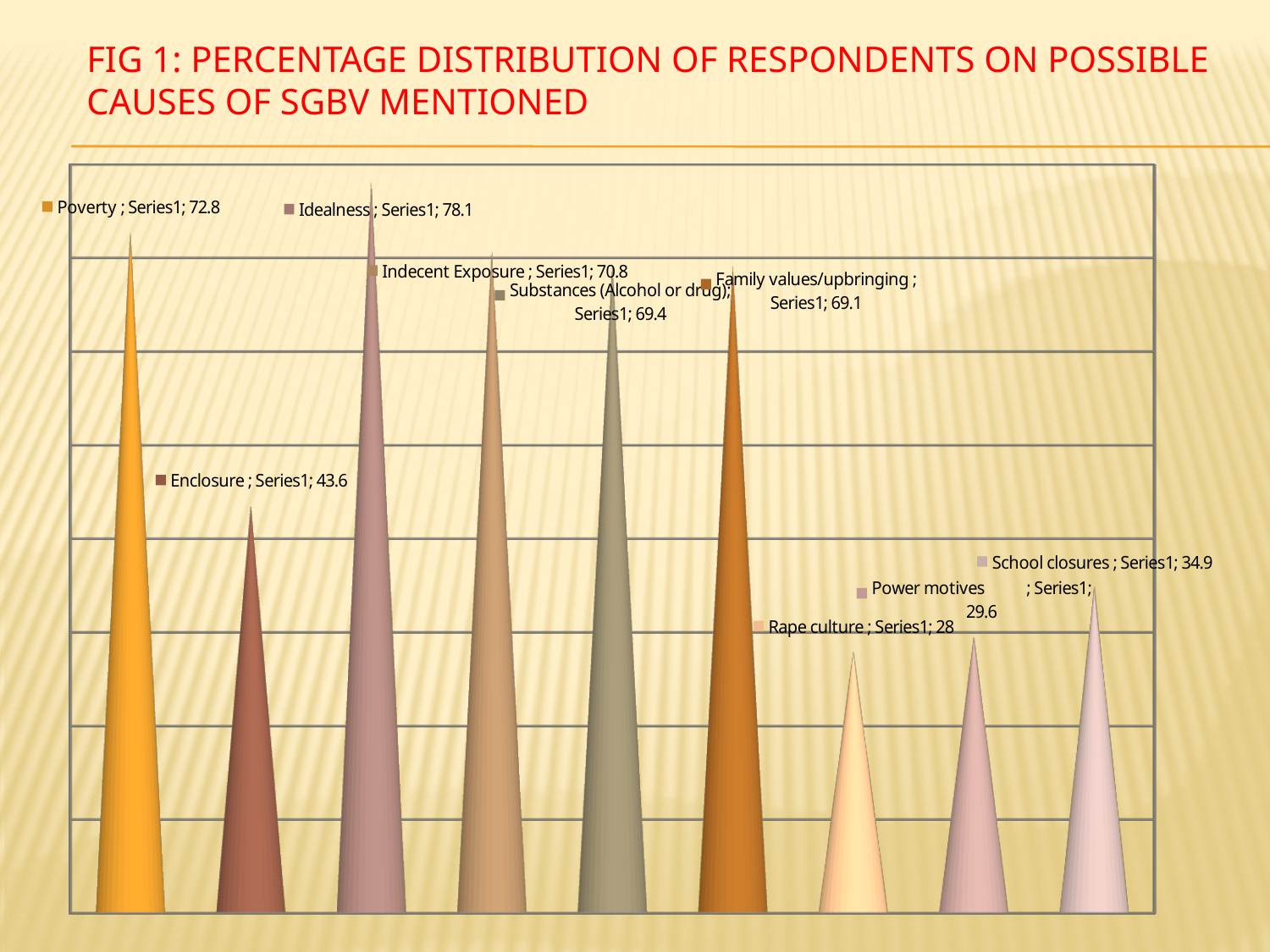
What is the difference between the values for Idealness and Poverty? 5.3 What kind of chart is shown on the slide? Bar chart What is the value for Enclosure? 43.6 How many categories are plotted in the chart? 9 What is the value for School closures? 34.9 What is the value for Substances (Alcohol or drug)? 69.4 Which category has the lowest value? Rape culture Which is larger, the value for Indecent Exposure or the value for Family values/upbringing? Indecent Exposure What is the value for Poverty? 72.8 What is the difference between the values for Power motives and Rape culture? 1.6 What is the title of the chart? FIG 1: PERCENTAGE DISTRIBUTION OF RESPONDENTS ON POSSIBLE CAUSES OF SGBV MENTIONED Which category has the highest value? Idealness